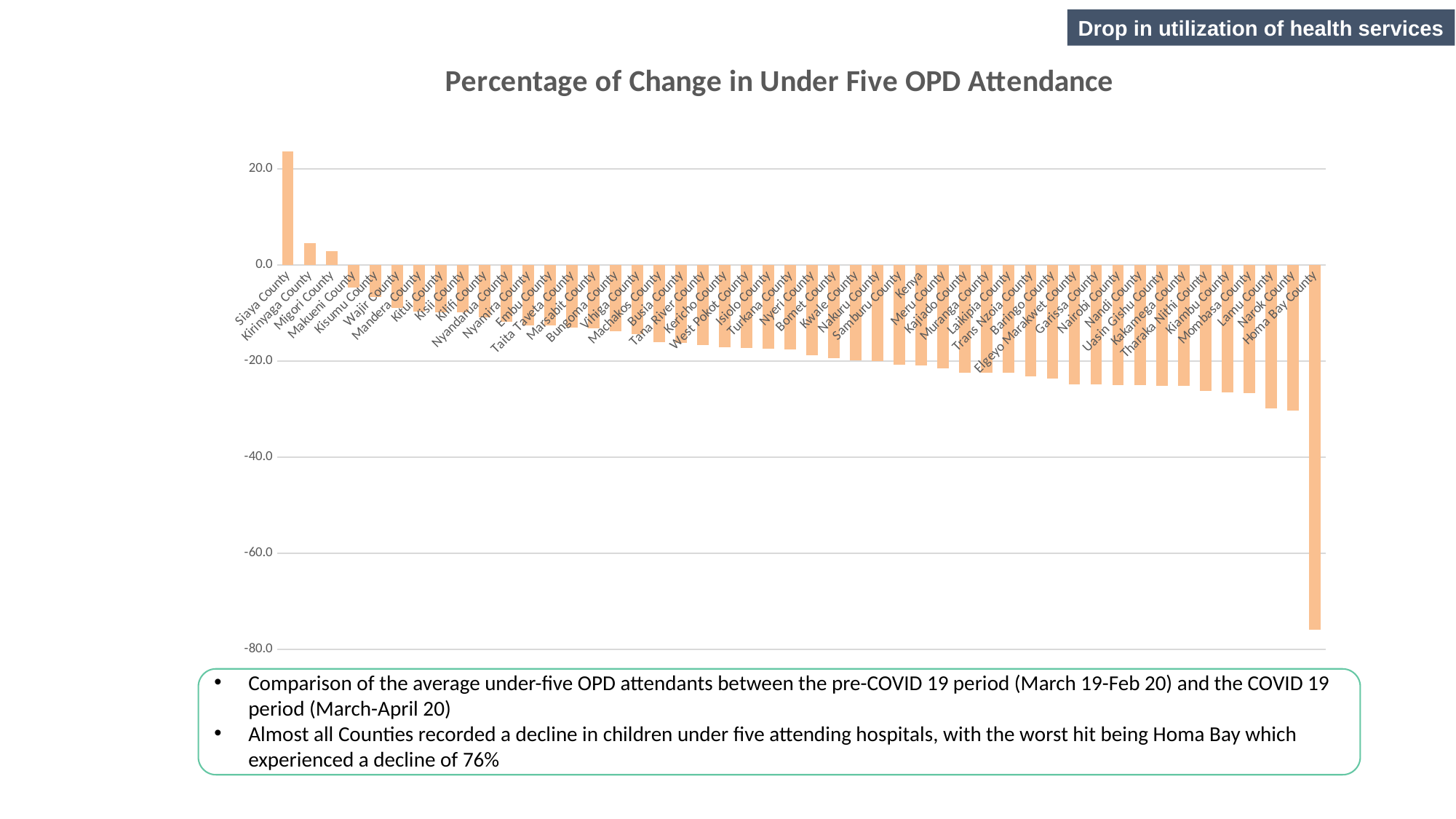
Which county has the lowest percentage change in under five OPD attendance? Homa Bay County What kind of chart is shown on the slide? Bar chart Is the value for Narok County greater or less than -20.0? less Is the value for Kisumu County greater or less than -20.0? greater Is the value for Siaya County greater or less than 20.0? greater Which has the larger value, Siaya County or Kirinyaga County? Siaya County According to the slide text, what decline in under five OPD attendance did Homa Bay experience? 76% How many counties show a positive percentage change (bars above 0.0)? 3 What is the title of the chart? Percentage of Change in Under Five OPD Attendance Which county has the highest percentage change in under five OPD attendance? Siaya County Do the values generally rise or fall moving from left to right along the x axis? Fall